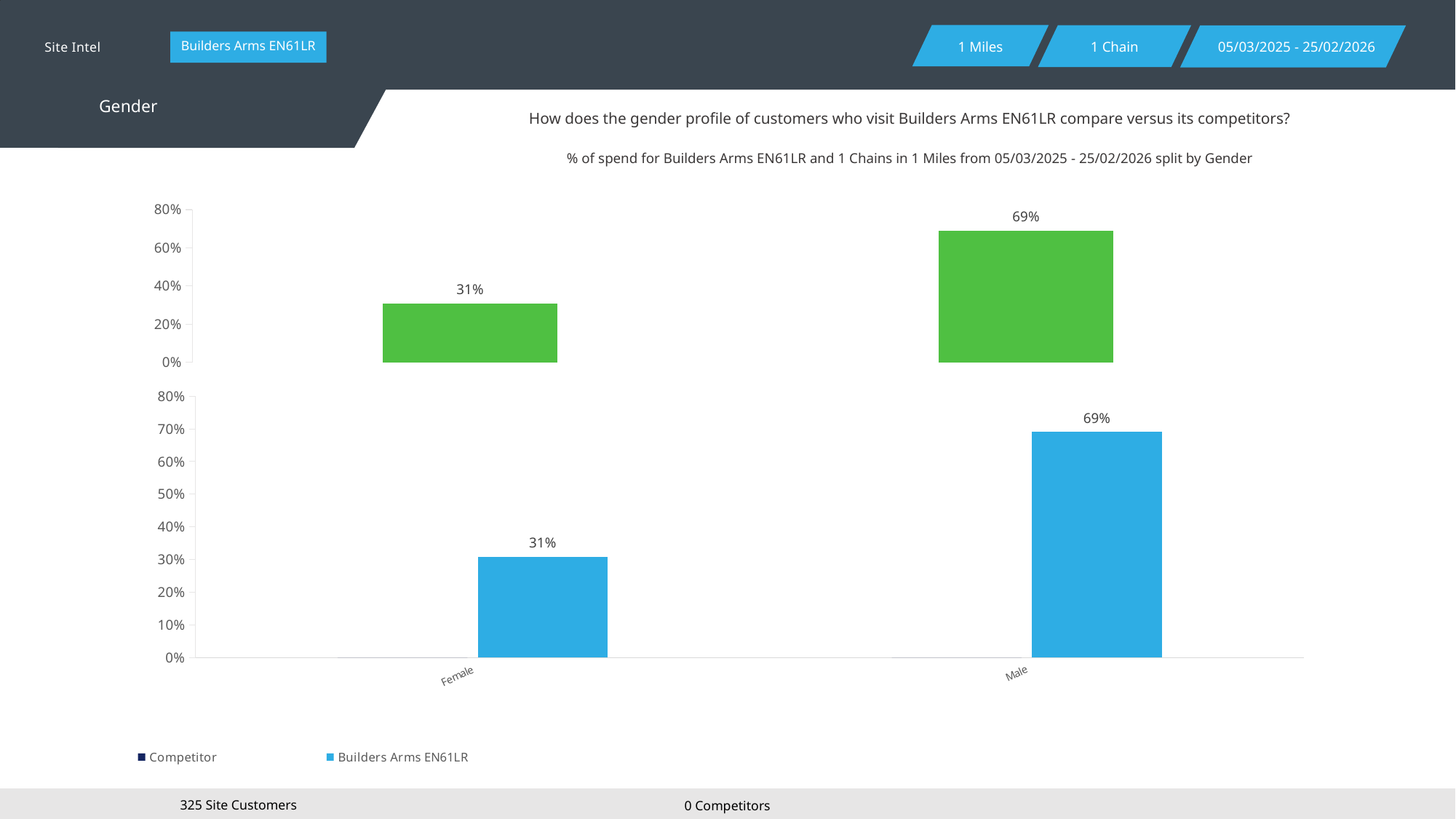
In the bottom chart, which category has the lowest value? Female In the bottom chart, what is the value for Female? 31% In the bottom chart, is the value for Female greater or less than 40%? less In the top chart, what is the value of the left (Female) bar? 31% In the top chart, what is the value of the right (Male) bar? 69% In the bottom chart, what is the value for Male? 69% What is the highest tick value shown on the y axis of the bottom chart? 80% How many series does the legend at the bottom of the slide list? 2 What kind of chart is the bottom chart? bar chart In the bottom chart, which category has the highest value? Male In the bottom chart, how many categories are shown on the x axis? 2 In the bottom chart, what is the difference between the Male and Female values? 38%